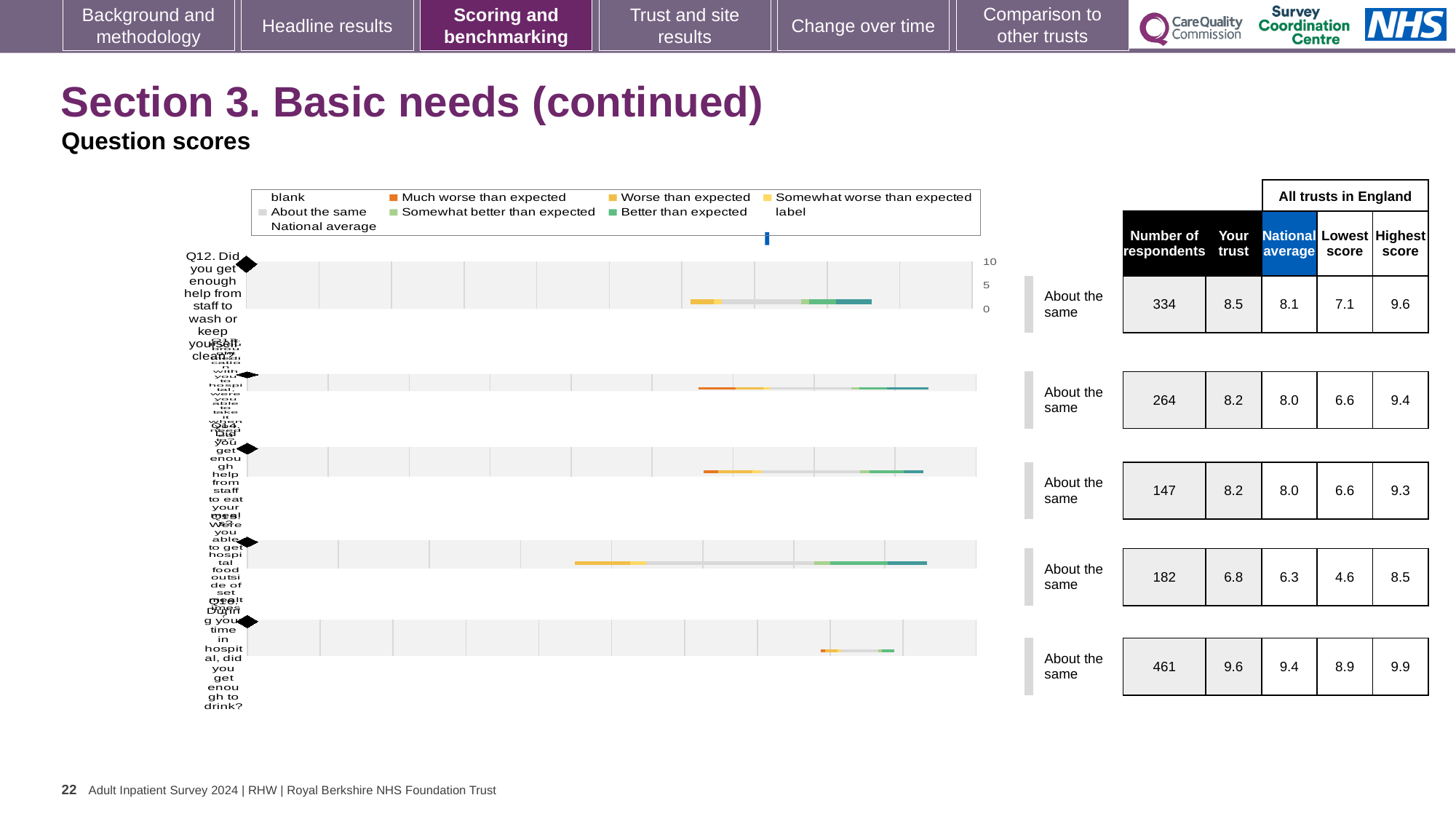
What benchmark category is shown for every question bar in the chart? About the same What is the difference between the 'Your trust' score and the national average for Q12 (help from staff to wash or keep yourself clean)? 0.4 According to the table beside the chart, what is the 'Your trust' score for Q12 (help from staff to wash or keep yourself clean)? 8.5 In the chart legend, what colour represents 'Much worse than expected'? orange According to the table beside the chart, how many respondents answered Q12 (help from staff to wash or keep yourself clean)? 334 According to the table beside the chart, what is the highest score across all trusts in England for the question about getting enough to drink? 9.9 According to the table beside the chart, what is the 'Your trust' score for the question about getting enough to drink during your time in hospital? 9.6 How many question bars are plotted in the chart? 5 In the chart legend, what colour represents 'About the same'? grey What kind of chart is shown on the slide? bar chart Which question has the lowest 'Your trust' score in the table beside the chart? Were you able to get hospital food outside of set meal times? (6.8) According to the table beside the chart, what is the national average for Q12 (help from staff to wash or keep yourself clean)? 8.1